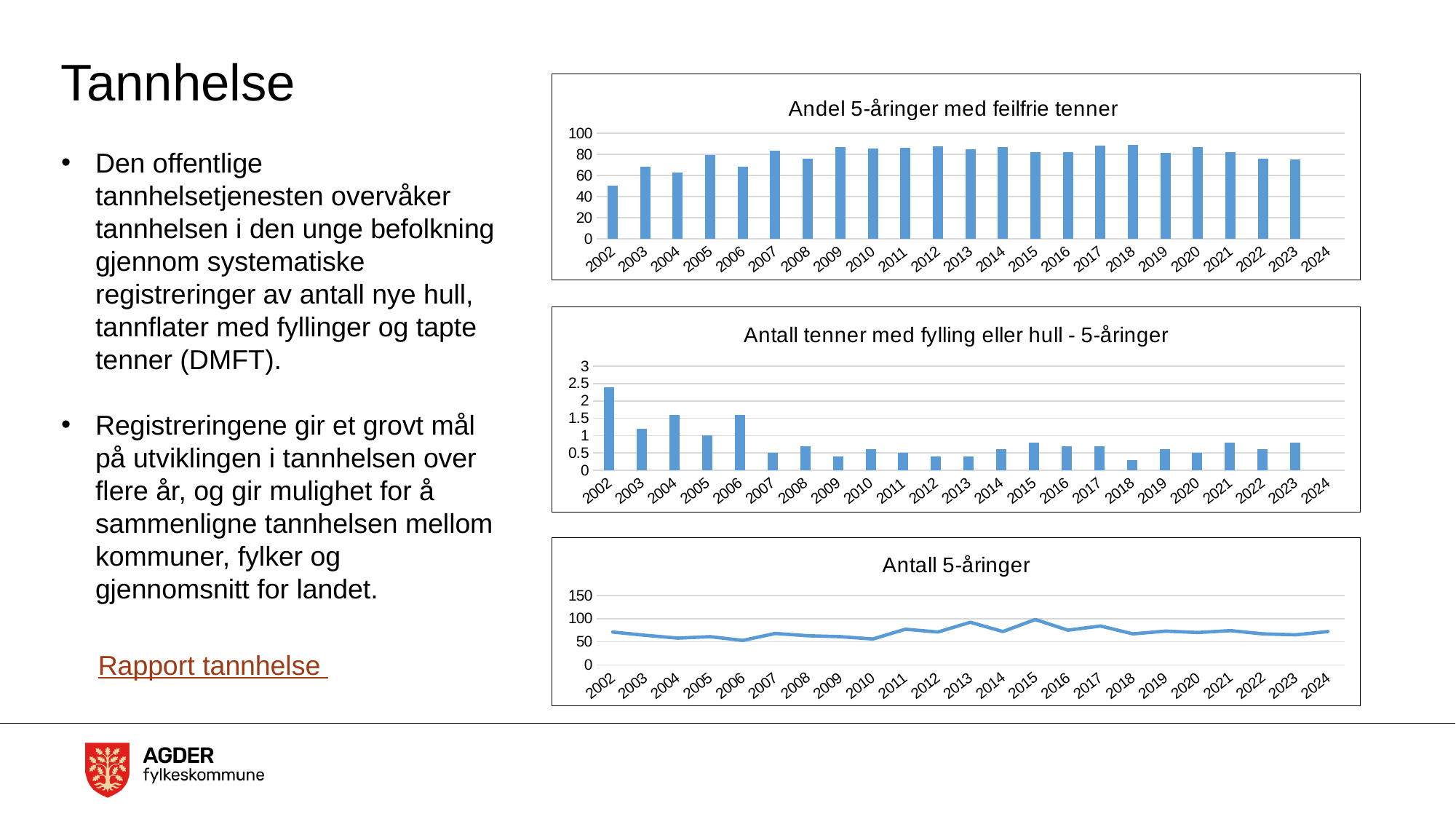
In the chart "Antall 5-åringer", which year has the highest value? 2015 In the chart "Antall tenner med fylling eller hull - 5-åringer", is the value for 2007 greater or less than 1? less In the chart "Antall tenner med fylling eller hull - 5-åringer", do the values generally rise or fall from 2002 to 2023? fall What kind of chart is "Andel 5-åringer med feilfrie tenner"? bar chart In the chart "Antall tenner med fylling eller hull - 5-åringer", which is larger, the value for 2002 or the value for 2003? 2002 In the chart "Antall tenner med fylling eller hull - 5-åringer", is the value for 2002 greater or less than 2? greater In the chart "Andel 5-åringer med feilfrie tenner", is the value for 2004 greater or less than 80? less What kind of chart is "Antall 5-åringer"? line chart How many years are labelled on the x axis of the chart "Antall 5-åringer"? 23 In the chart "Andel 5-åringer med feilfrie tenner", which year has the lowest value? 2002 In the chart "Antall tenner med fylling eller hull - 5-åringer", which year has the highest value? 2002